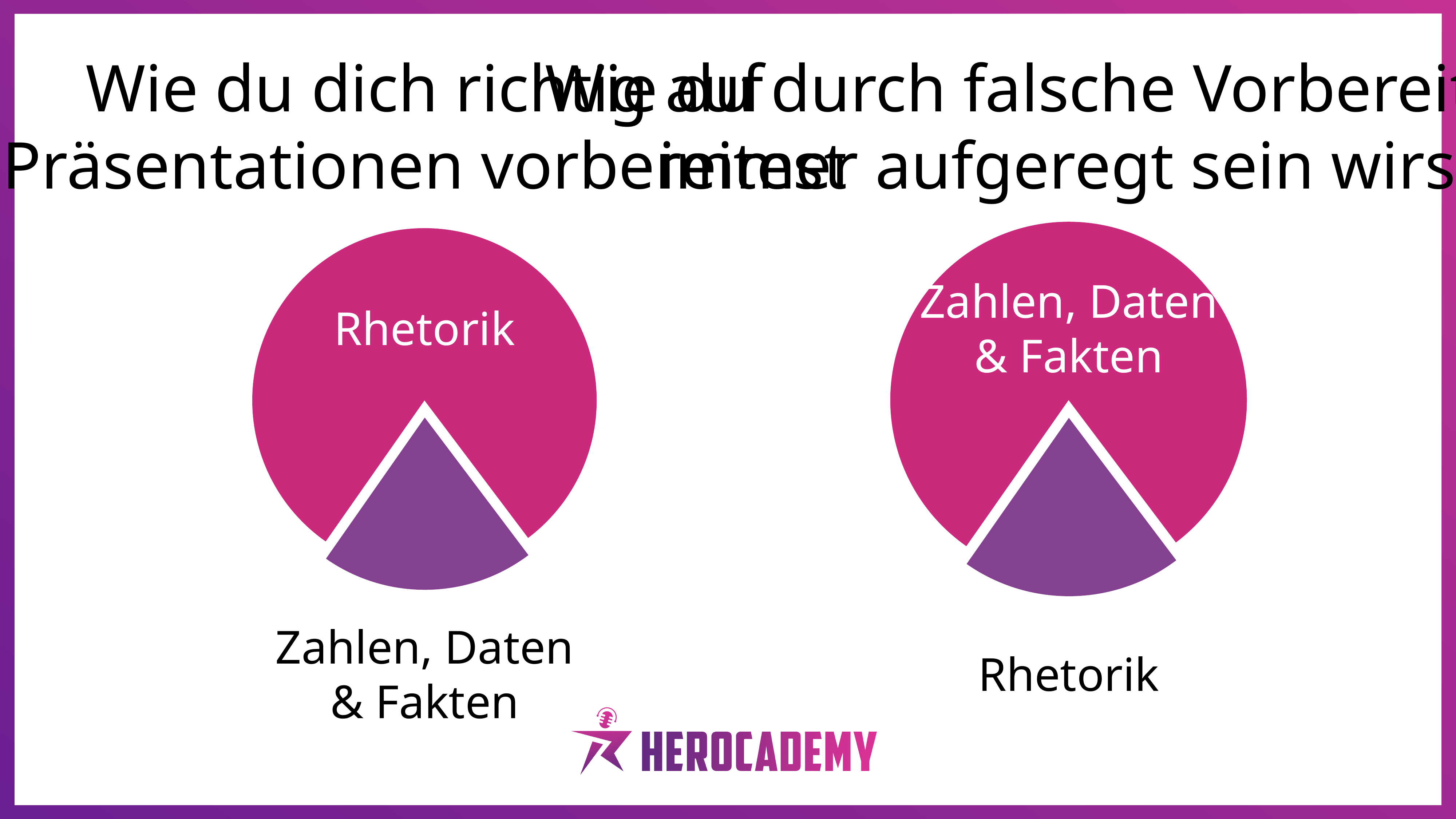
In the left pie chart, what colour is the Rhetorik slice? pink In the left pie chart, which is larger: the Rhetorik slice or the Zahlen, Daten & Fakten slice? Rhetorik What kind of chart is the left chart on the slide? pie chart In the right pie chart, which slice is the smallest? Rhetorik What kind of chart is the right chart on the slide? pie chart In the left pie chart, which slice is the smallest? Zahlen, Daten & Fakten In the left pie chart, which slice is the largest? Rhetorik In the right pie chart, which slice is the largest? Zahlen, Daten & Fakten In the right pie chart, what colour is the Rhetorik slice? purple In the left pie chart, how many slices are there? 2 In the right pie chart, which is larger: the Rhetorik slice or the Zahlen, Daten & Fakten slice? Zahlen, Daten & Fakten In the right pie chart, how many slices are there? 2